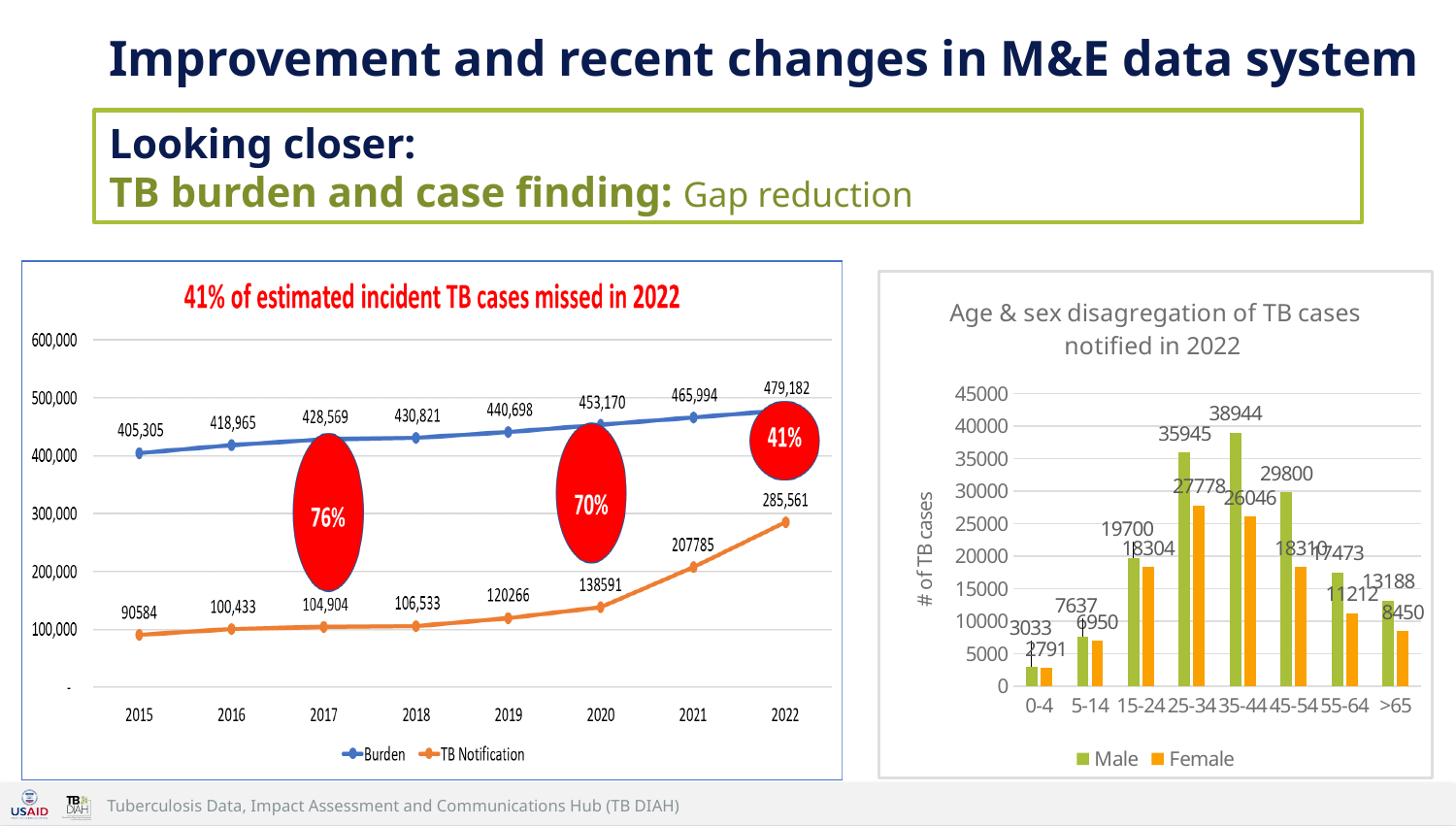
In the left chart, what percentage is shown in the red circle for 2017? 76% What kind of chart is the right chart? bar chart In the left chart, does the TB Notification series rise or fall from 2015 to 2022? rise In the left chart, which year has the highest TB Notification value? 2022 In the right chart, which age group has the lowest Female value? 0-4 In the left chart, what is the TB Notification value for 2015? 90584 In the right chart, what is the Female value for the >65 age group? 8450 In the left chart, how many series does the legend list? 2 In the left chart, what is the difference between the Burden and TB Notification values in 2021? 258,209 In the right chart, what is the Male value for the 35-44 age group? 38944 In the left chart, what is the Burden value for 2022? 479,182 In the right chart, how many age groups are shown on the x axis? 8